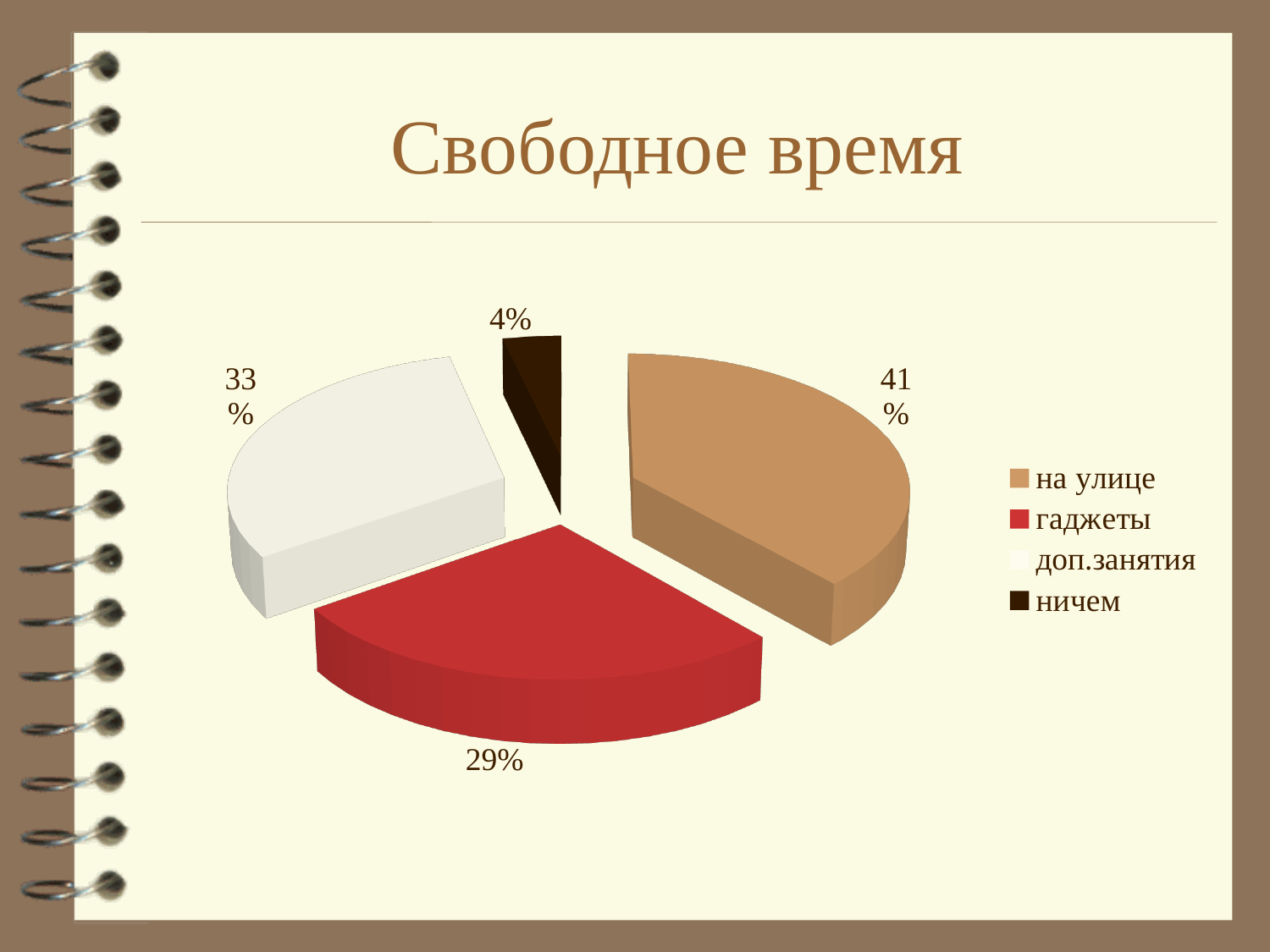
Which is larger, the share for "доп.занятия" or the share for "гаджеты"? доп.занятия What percentage is shown for the "ничем" slice? 4% What kind of chart is shown on the slide? pie chart What percentage is shown for the "доп.занятия" slice? 33% Which category has the smallest share of the pie? ничем What colour is the slice for "гаджеты"? red What is the title of the chart on the slide? Свободное время What percentage of the pie is labelled for "на улице"? 41% Which category has the largest share of the pie? на улице How many slices does the pie chart have? 4 What is the difference in percentage points between "на улице" and "гаджеты"? 12 What percentage is shown for the "гаджеты" slice? 29%